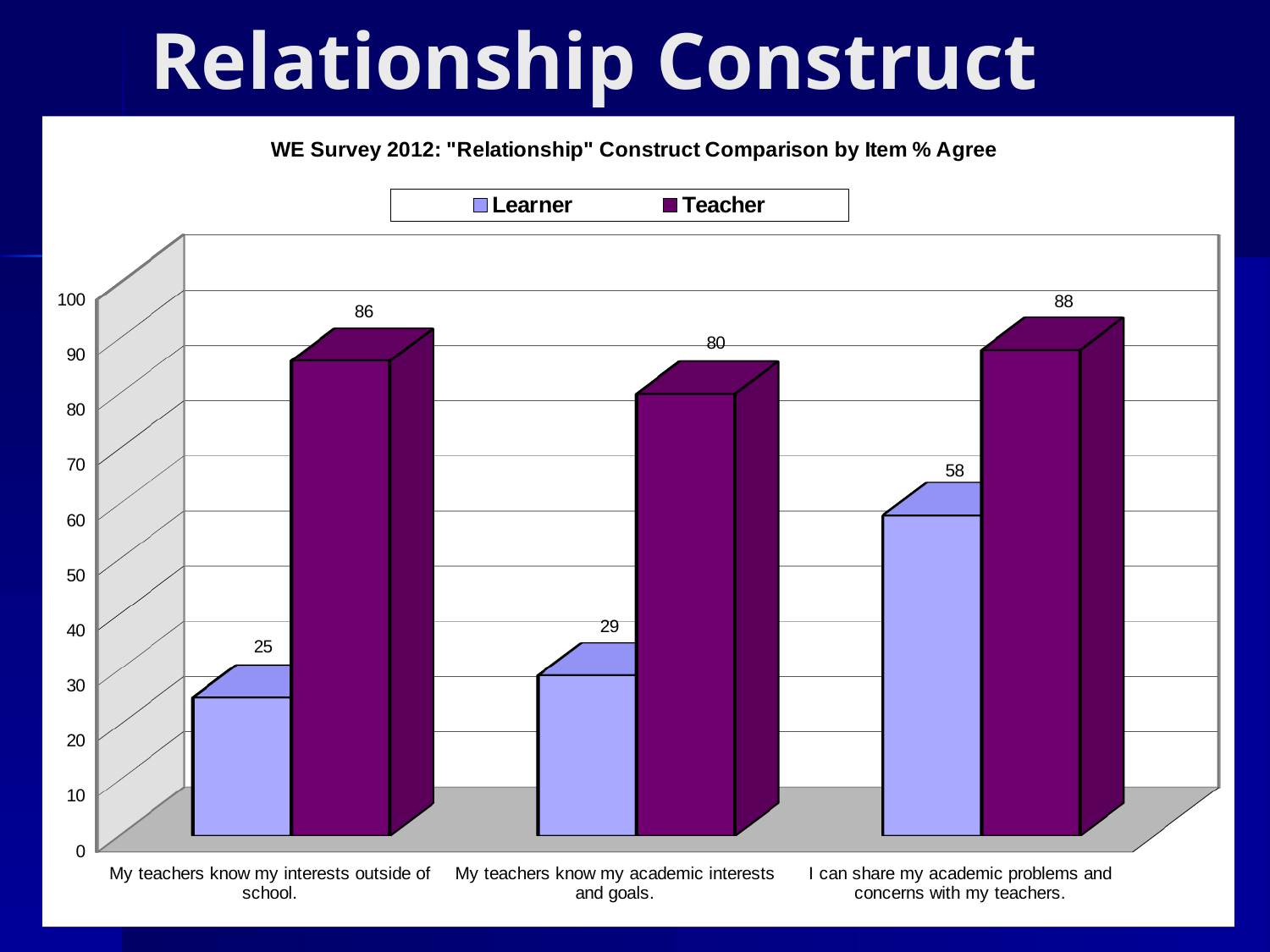
What kind of chart is shown on the slide? Bar chart What is the Learner value for "My teachers know my interests outside of school."? 25 Which item has the highest Teacher value? I can share my academic problems and concerns with my teachers. How many items (categories) are shown on the x axis? 3 Do the Learner values rise or fall from left to right across the items? Rise Which item has the lowest Learner value? My teachers know my interests outside of school. How many series does the legend list? 2 Which is larger for "My teachers know my academic interests and goals.": the Learner value or the Teacher value? Teacher What is the Teacher value for "My teachers know my academic interests and goals."? 80 What is the difference between the Teacher and Learner values for "My teachers know my interests outside of school."? 61 What is the Learner value for "I can share my academic problems and concerns with my teachers."? 58 What is the title of the chart? WE Survey 2012: "Relationship" Construct Comparison by Item % Agree